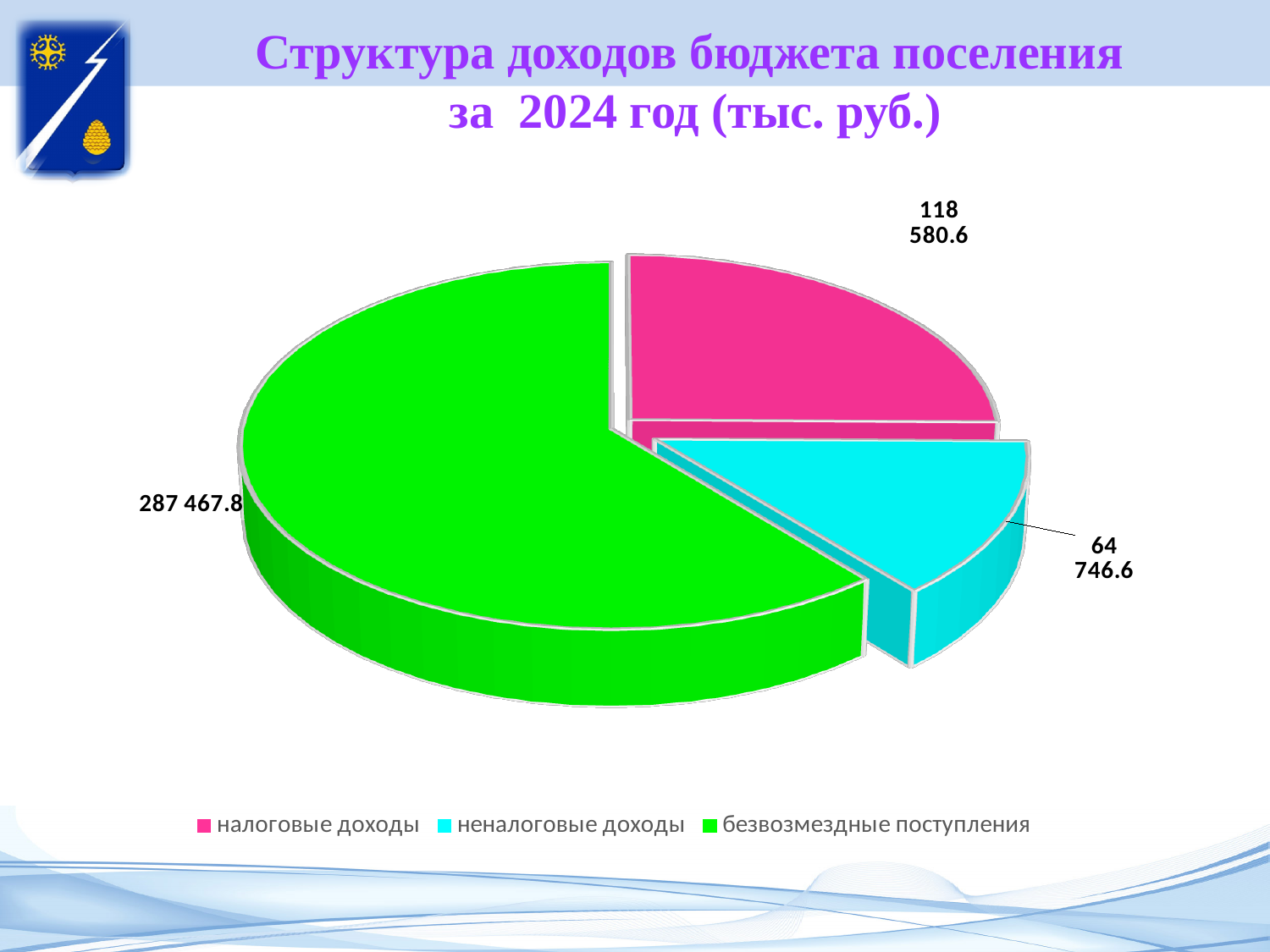
How many entries does the legend list? 3 What type of chart is shown on the slide? pie chart What is the difference between безвозмездные поступления and налоговые доходы? 168 887.2 What is the difference between налоговые доходы and неналоговые доходы? 53 834.0 What is the value for безвозмездные поступления? 287 467.8 What colour is the slice for безвозмездные поступления? green What is the value for налоговые доходы? 118 580.6 Which is larger, налоговые доходы or неналоговые доходы? налоговые доходы What is the value for неналоговые доходы? 64 746.6 Which category has the largest value? безвозмездные поступления Which category has the smallest value? неналоговые доходы How many slices does the pie chart have? 3